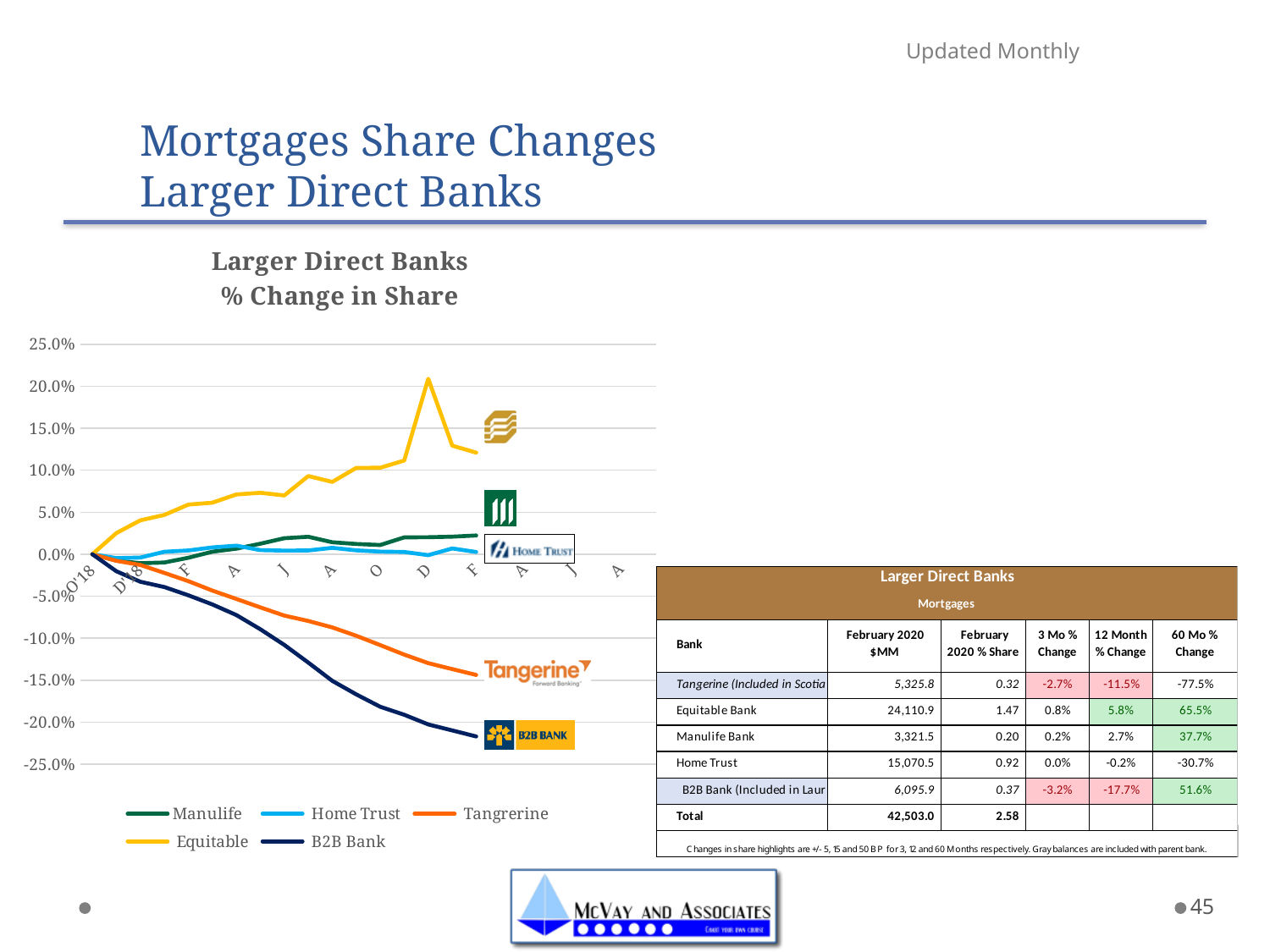
Does the Equitable line generally rise or fall along the x axis? Rise Which series is plotted in yellow on the chart? Equitable Is the final value for Equitable greater or less than 10.0%? greater Which series has the highest value at the right end of the chart? Equitable What kind of chart is shown on the slide? Line chart At the right end of the chart, which is larger: the value for Manulife or the value for Tangerine? Manulife Does the B2B Bank line generally rise or fall along the x axis? Fall How many series does the chart legend list? 5 Is the final value for B2B Bank greater or less than -20.0%? less What is the title of the chart? Larger Direct Banks % Change in Share Is the final value for Tangerine greater or less than -10.0%? less Which series has the lowest value at the right end of the chart? B2B Bank